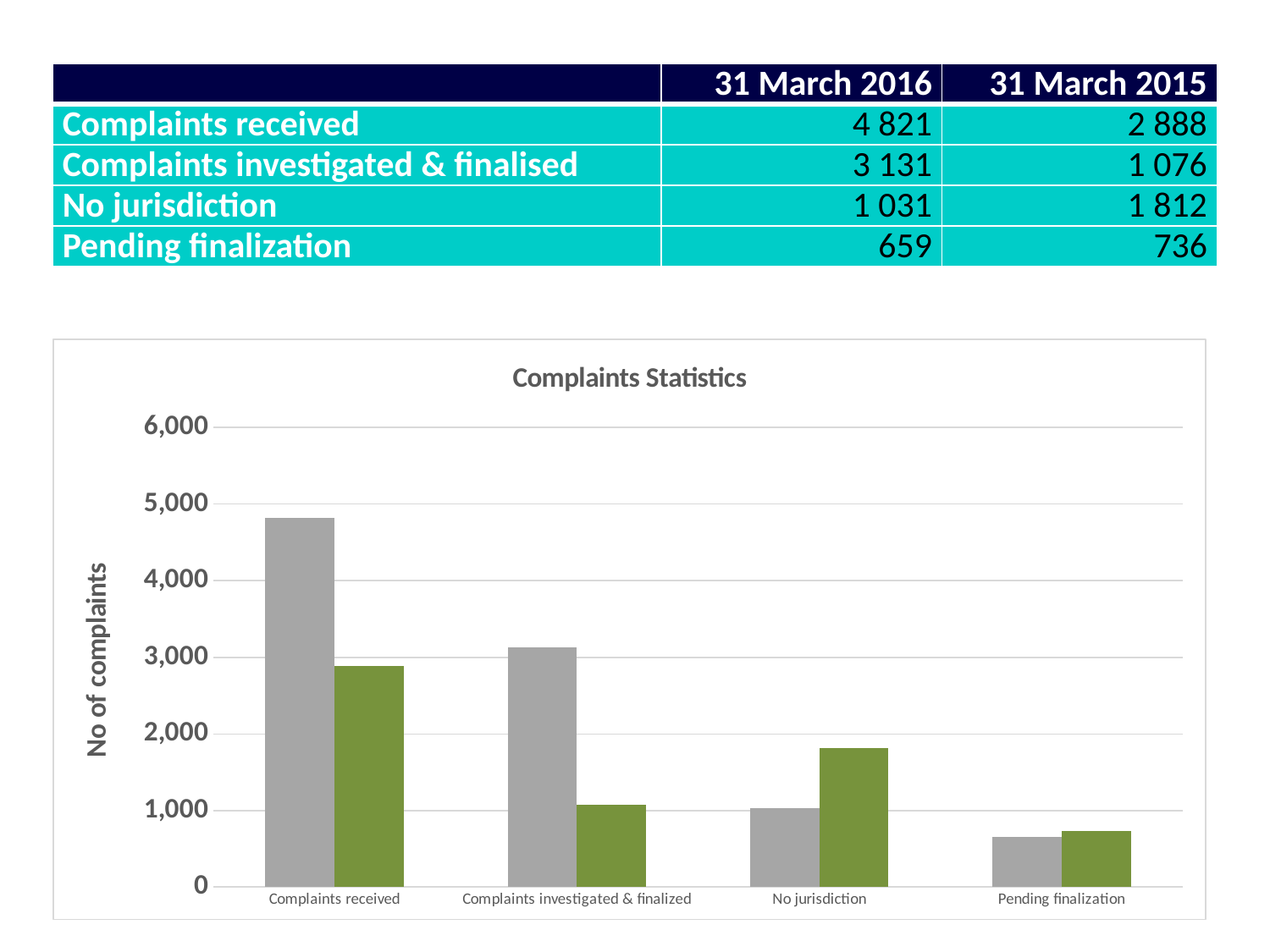
How many categories are shown on the x axis of the "Complaints Statistics" chart? 4 For "No jurisdiction", which is larger: the 31 March 2016 value or the 31 March 2015 value? 31 March 2015 In the "Complaints Statistics" chart, is the grey bar for "Complaints investigated & finalized" greater or less than 3,000? greater What is the y-axis label of the "Complaints Statistics" chart? No of complaints In the "Complaints Statistics" chart, is the green bar for "Pending finalization" greater or less than 1,000? less What is the title of the chart on the slide? Complaints Statistics According to the slide, how many complaints were pending finalization as at 31 March 2015? 736 According to the slide, how many complaints were received as at 31 March 2016? 4 821 Which category has the lowest value for 31 March 2015? Pending finalization What is the difference between complaints received at 31 March 2016 and at 31 March 2015? 1 933 Which category has the highest value for 31 March 2016? Complaints received What kind of chart is the "Complaints Statistics" chart? bar chart